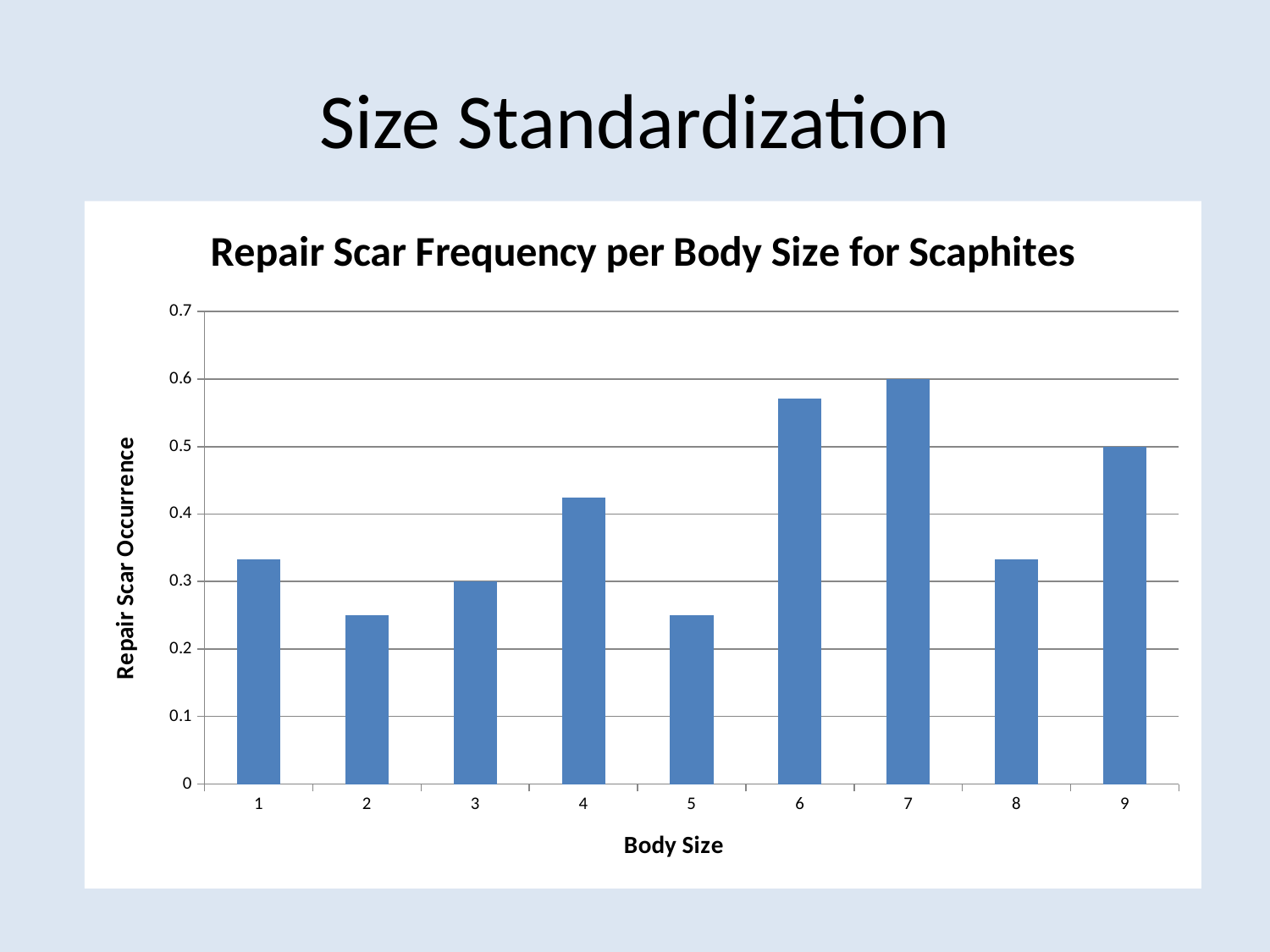
How many body size categories are plotted on the x axis? 9 What type of chart is shown on the slide? Bar chart What is the label of the vertical axis? Repair Scar Occurrence What is the repair scar occurrence for body size 3? 0.3 What is the title of the chart? Repair Scar Frequency per Body Size for Scaphites Is the value for body size 4 greater or less than 0.4? greater Which body size has the highest repair scar occurrence? 7 Is the value for body size 2 greater or less than 0.3? less Is the value for body size 6 greater or less than 0.5? greater What is the repair scar occurrence for body size 7? 0.6 What is the repair scar occurrence for body size 9? 0.5 Which has a higher repair scar occurrence, body size 4 or body size 9? Body size 9